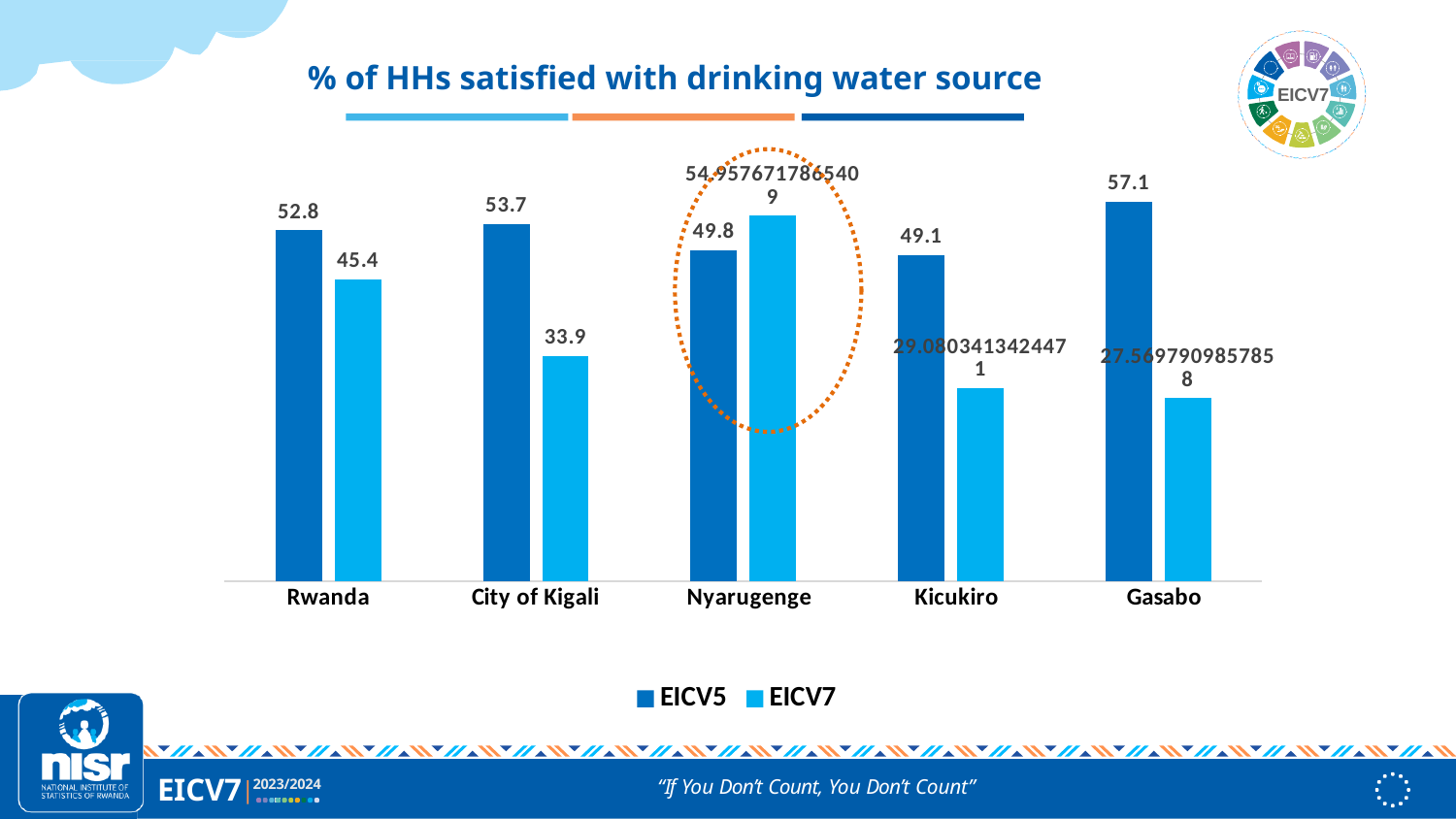
Which category has the highest EICV5 value? Gasabo What is the EICV5 value for Gasabo? 57.1 What is the difference between the EICV5 and EICV7 values for Rwanda? 7.4 For Nyarugenge, which is larger: the EICV5 value or the EICV7 value? EICV7 How many categories are shown on the x axis? 5 What is the difference between the EICV5 and EICV7 values for City of Kigali? 19.8 What type of chart is shown on the slide? Bar chart What is the EICV7 value for Rwanda? 45.4 How many series does the legend list? 2 What is the EICV7 value for City of Kigali? 33.9 Which category has the lowest EICV5 value? Kicukiro What is the EICV5 value for Rwanda? 52.8